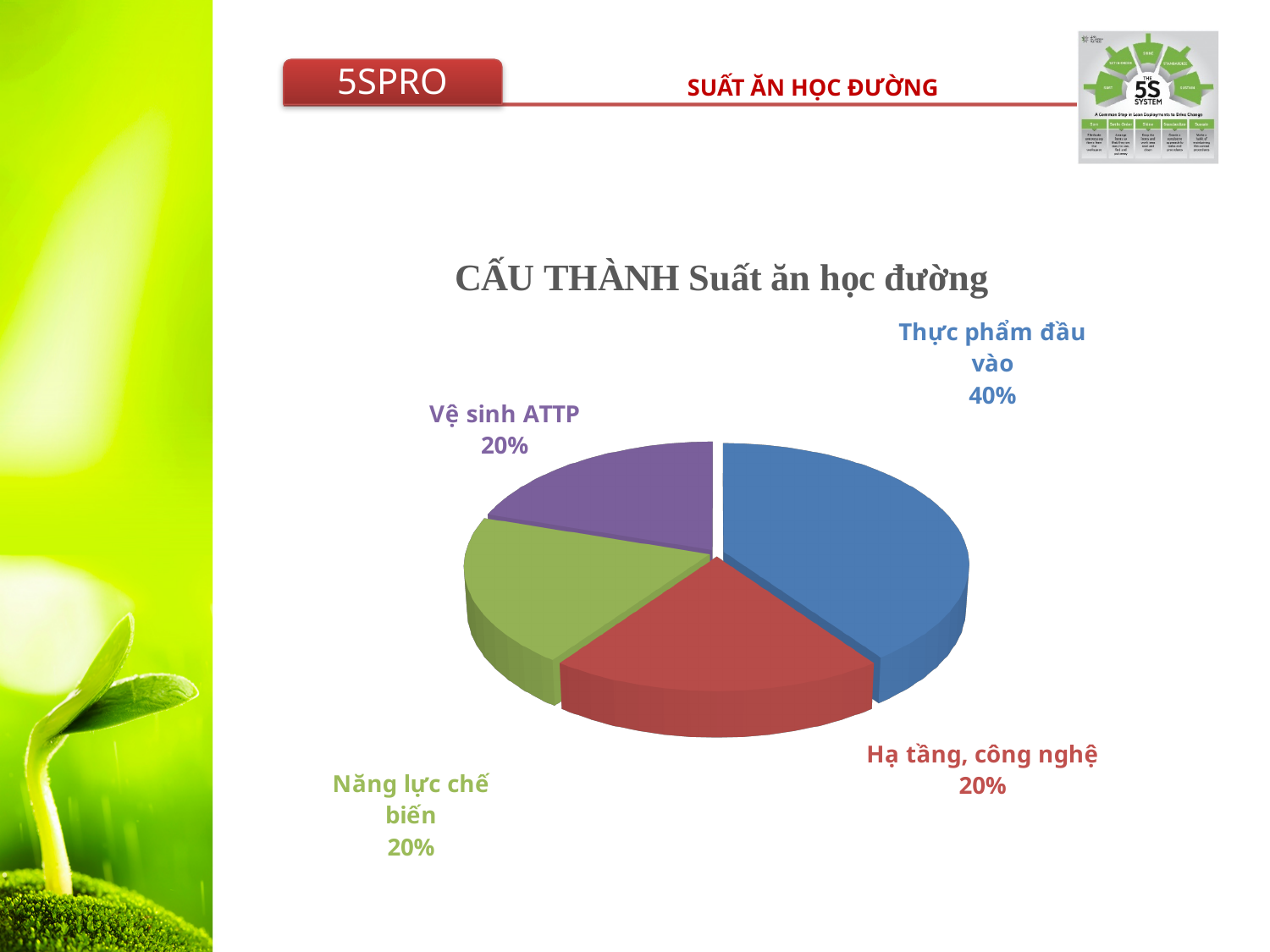
What is the combined share of "Vệ sinh ATTP" and "Năng lực chế biến"? 40% What is the difference between the share of "Thực phẩm đầu vào" and the share of "Vệ sinh ATTP"? 20% What is the value shown for "Năng lực chế biến"? 20% How many categories (slices) does the pie chart have? 4 What is the title of the chart? CẤU THÀNH Suất ăn học đường What colour is the slice for "Thực phẩm đầu vào"? Blue What type of chart is shown on the slide? Pie chart What share of the pie does "Thực phẩm đầu vào" represent? 40% Which category has the largest share of the pie? Thực phẩm đầu vào What is the value shown for "Hạ tầng, công nghệ"? 20% What is the value shown for "Vệ sinh ATTP"? 20% Which is larger: the share of "Thực phẩm đầu vào" or the share of "Hạ tầng, công nghệ"? Thực phẩm đầu vào